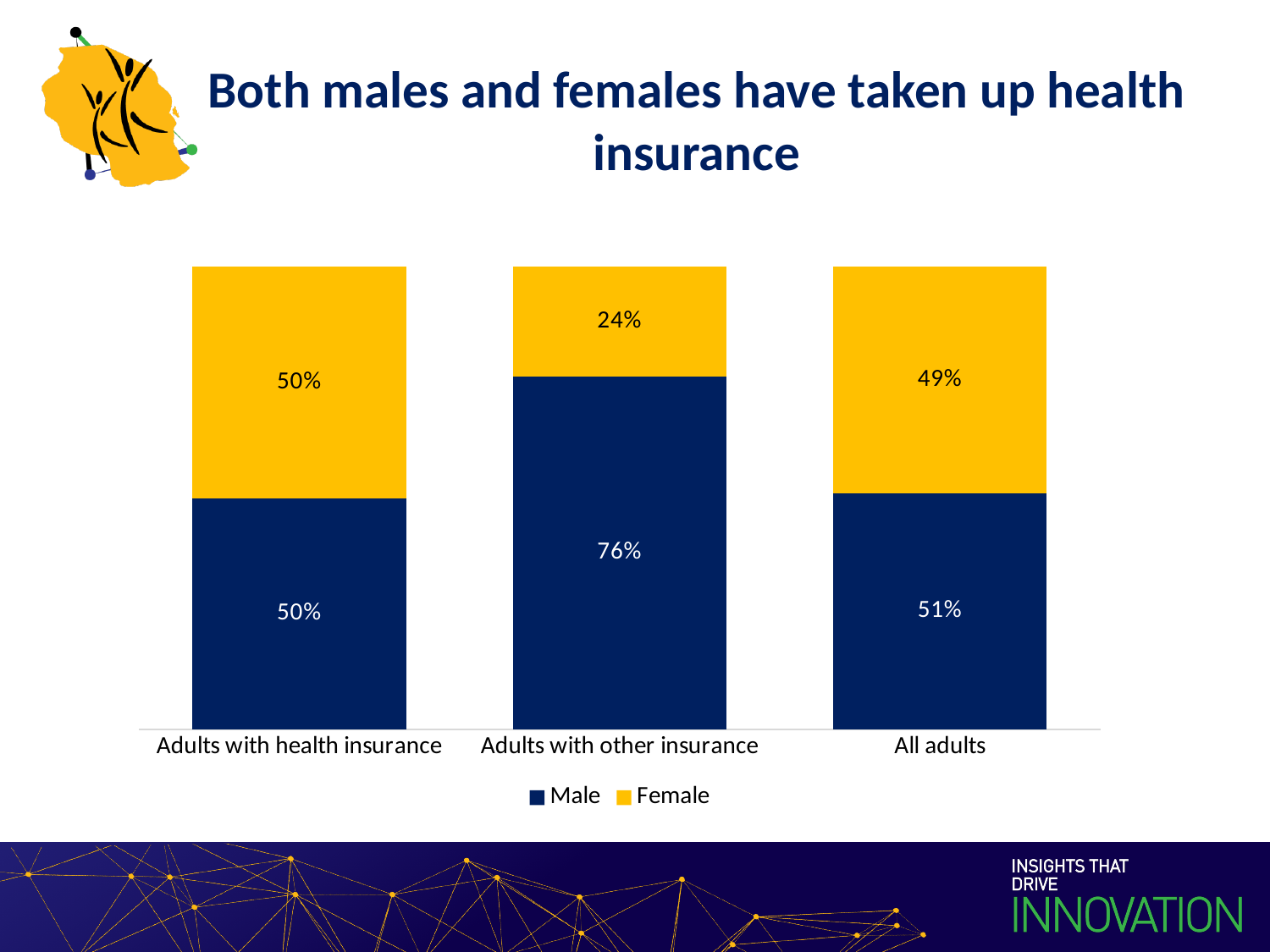
What is the Female value for All adults? 49% Which colour represents the Female series? Yellow What is the Female value for Adults with other insurance? 24% What is the Male value for Adults with other insurance? 76% Which category has the highest Male value? Adults with other insurance Which category has the lowest Female value? Adults with other insurance What kind of chart is shown on the slide? Stacked bar chart How many categories are shown on the x axis? 3 For All adults, which is larger, the Male value or the Female value? Male What is the difference between the Male and Female values for Adults with other insurance? 52% How many series does the legend list? 2 What is the Male value for Adults with health insurance? 50%